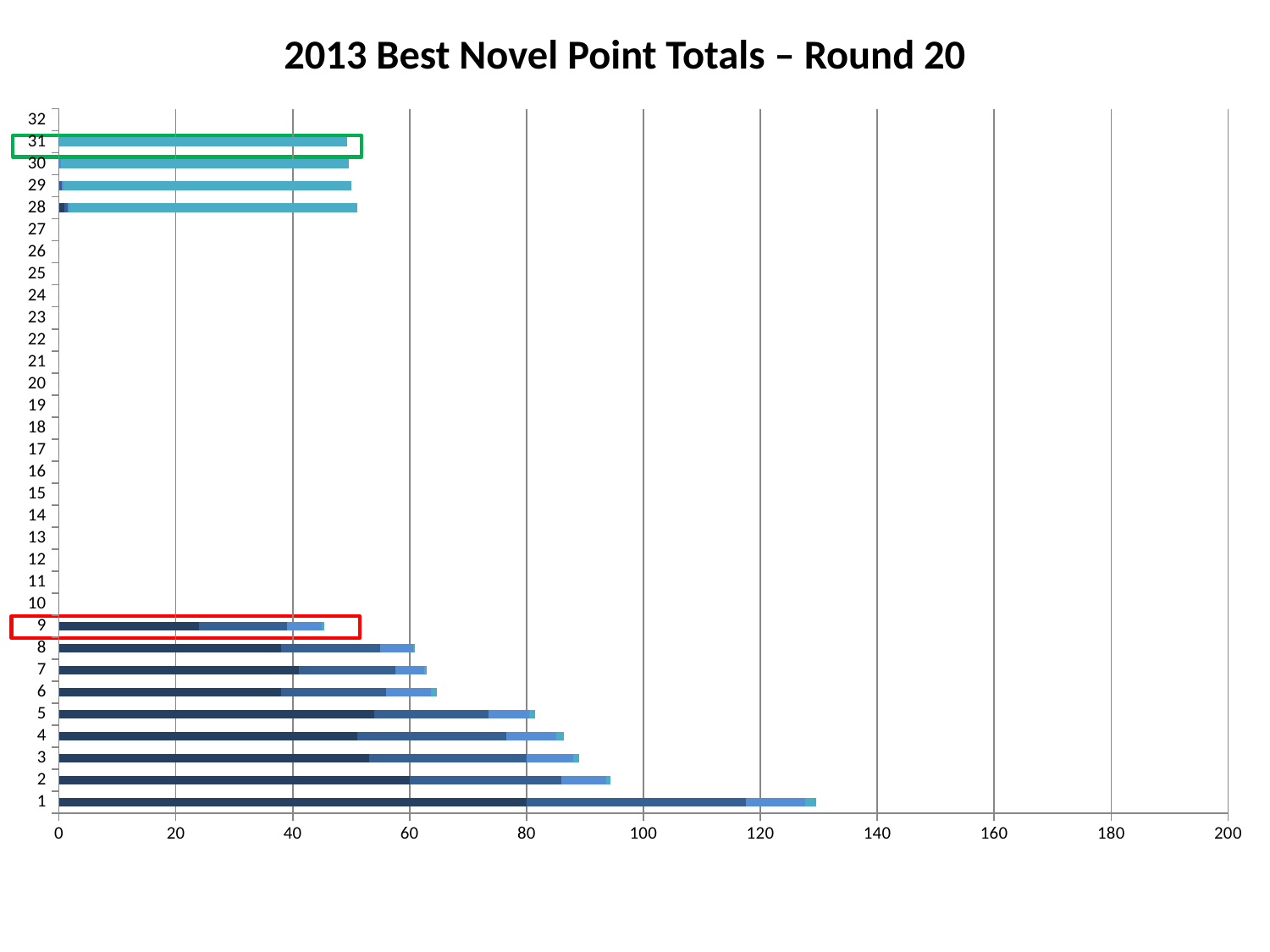
What kind of chart is shown on the slide? bar chart Is the value for category 8 greater or less than 80? less How many categories are labelled on the vertical axis? 32 Which has the larger total, category 5 or category 6? 5 Is the value for category 2 greater or less than 100? less Is the value for category 9 greater or less than 40? greater What is the title of the chart? 2013 Best Novel Point Totals – Round 20 Which category is highlighted with a red box? 9 Which category has the longest bar? 1 Which has the larger total, category 1 or category 2? 1